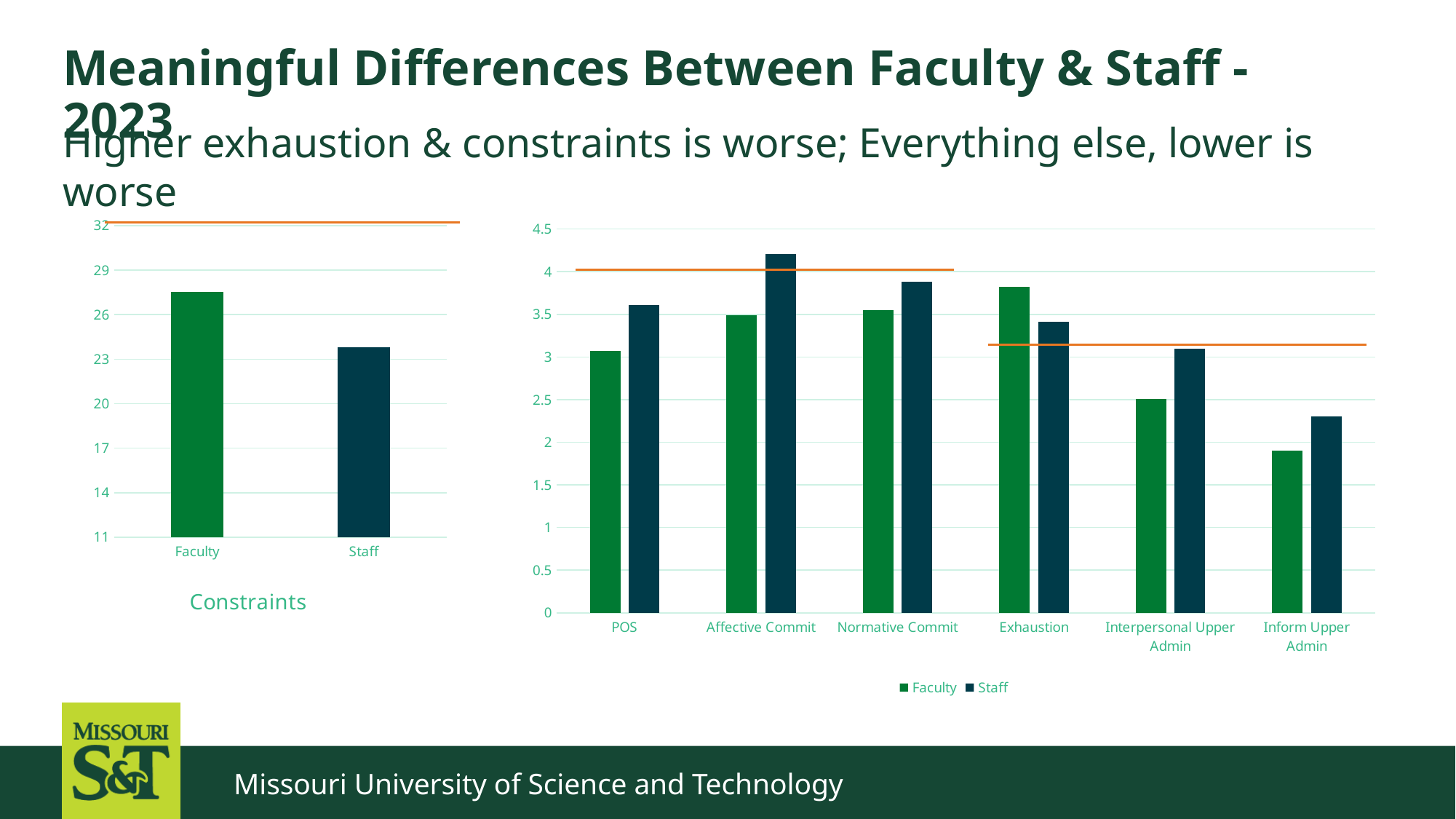
On the chart on the right, which category has the highest Staff value? Affective Commit On the Constraints chart on the left, is the value for Faculty greater or less than 26? greater On the Constraints chart on the left, is the value for Staff greater or less than 26? less On the chart on the right, for Exhaustion, which is larger, the Faculty value or the Staff value? Faculty On the Constraints chart on the left, which group has the higher value, Faculty or Staff? Faculty On the chart on the right, how many categories are shown on the x axis? 6 On the chart on the right, which colour represents the Staff series in the legend? Dark blue-green On the Constraints chart on the left, how many bars are plotted? 2 On the chart on the right, how many series does the legend list? 2 On the chart on the right, which category has the lowest Faculty value? Inform Upper Admin On the chart on the right, is the Staff value for Affective Commit greater or less than 4? greater What kind of chart is the chart on the right of the slide? Bar chart